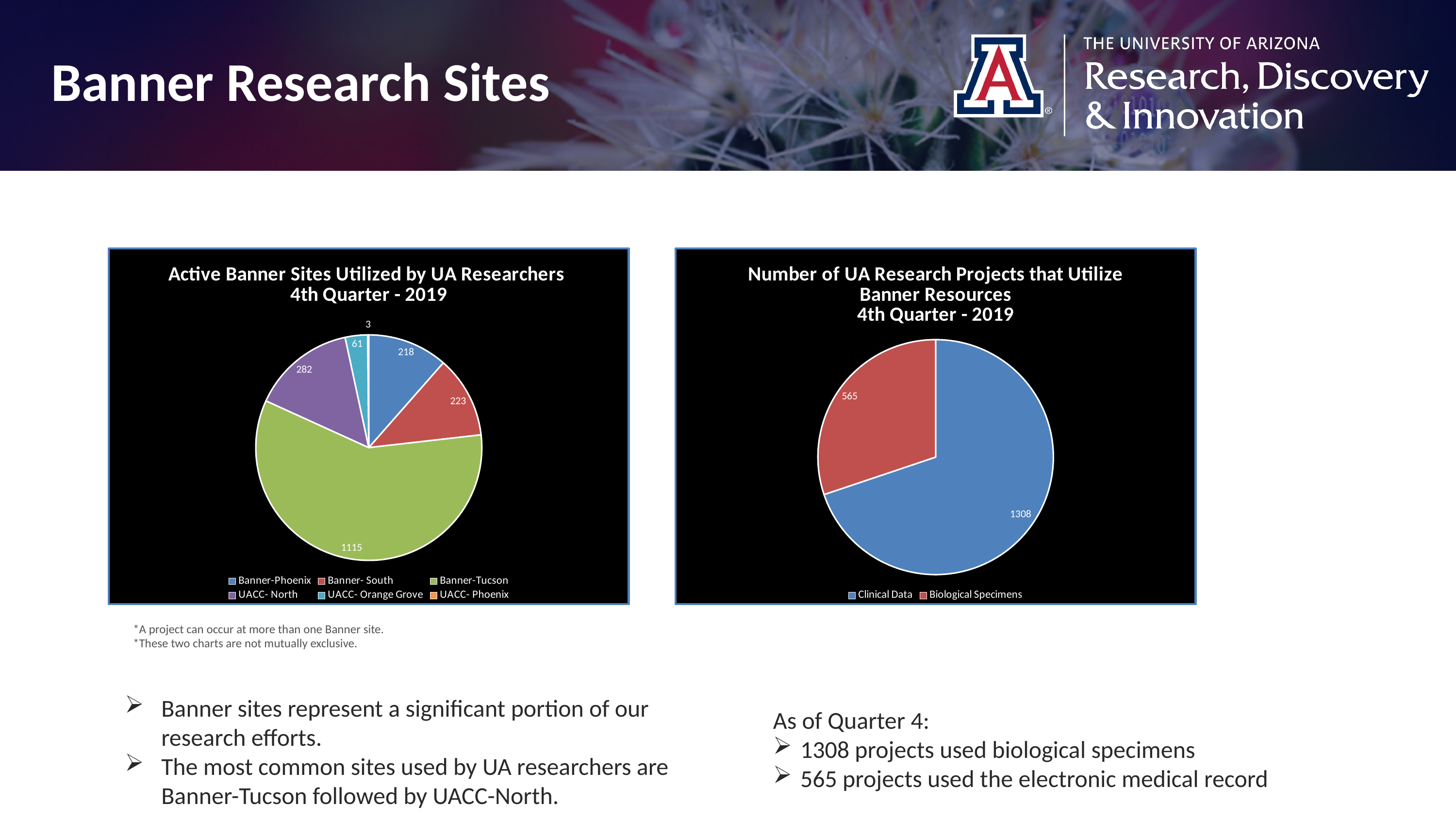
In the 'Active Banner Sites Utilized by UA Researchers' chart, what is the value for Banner-Tucson? 1115 In the 'Number of UA Research Projects that Utilize Banner Resources' chart, what is the value for Clinical Data? 1308 In the 'Number of UA Research Projects that Utilize Banner Resources' chart, what is the value for Biological Specimens? 565 In the 'Active Banner Sites Utilized by UA Researchers' chart, what is the value for UACC- North? 282 In the 'Active Banner Sites Utilized by UA Researchers' chart, which site has the smallest slice? UACC- Phoenix In the 'Active Banner Sites Utilized by UA Researchers' chart, which is larger, UACC- North or Banner- South? UACC- North In the 'Number of UA Research Projects that Utilize Banner Resources' chart, what is the difference between Clinical Data and Biological Specimens? 743 In the 'Active Banner Sites Utilized by UA Researchers' chart, which site has the largest slice? Banner-Tucson In the 'Active Banner Sites Utilized by UA Researchers' chart, what is the difference between Banner-Tucson and UACC- North? 833 What type of chart is the 'Number of UA Research Projects that Utilize Banner Resources' chart? Pie chart In the 'Active Banner Sites Utilized by UA Researchers' chart, how many sites are shown in the legend? 6 In the 'Active Banner Sites Utilized by UA Researchers' chart, what is the value for UACC- Orange Grove? 61